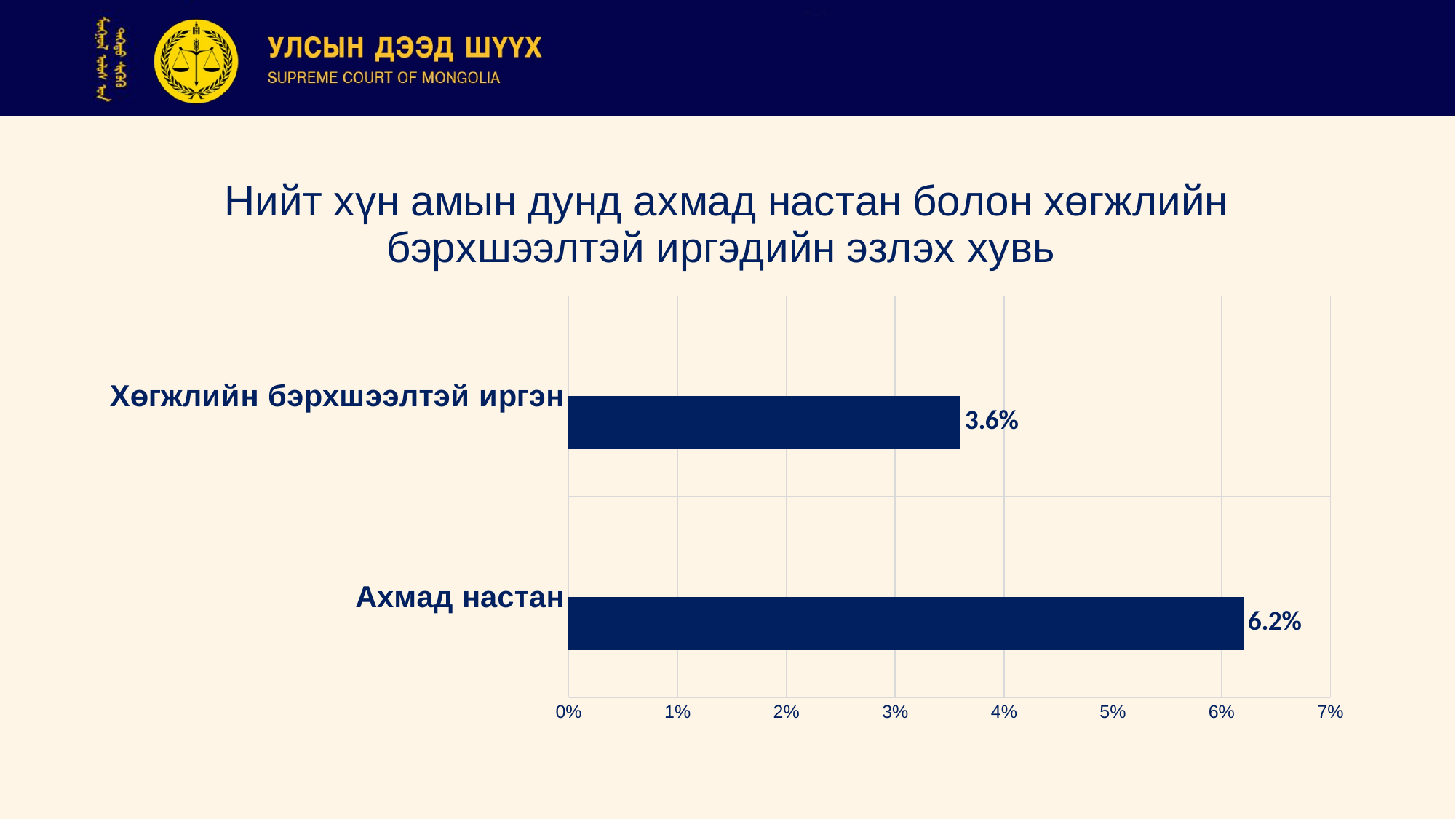
Which category has the highest value? Ахмад настан How many categories are shown in the chart? 2 Which is larger, the value for Ахмад настан or the value for Хөгжлийн бэрхшээлтэй иргэн? Ахмад настан What is the difference between the values for Ахмад настан and Хөгжлийн бэрхшээлтэй иргэн? 2.6% What is the value for Ахмад настан? 6.2% Which category has the lowest value? Хөгжлийн бэрхшээлтэй иргэн What is the value for Хөгжлийн бэрхшээлтэй иргэн? 3.6% Is the value for Ахмад настан greater or less than 5%? greater What is the maximum value shown on the x axis of the chart? 7% What kind of chart is shown on the slide? bar chart What is the title of the chart on the slide? Нийт хүн амын дунд ахмад настан болон хөгжлийн бэрхшээлтэй иргэдийн эзлэх хувь Is the value for Хөгжлийн бэрхшээлтэй иргэн greater or less than 4%? less